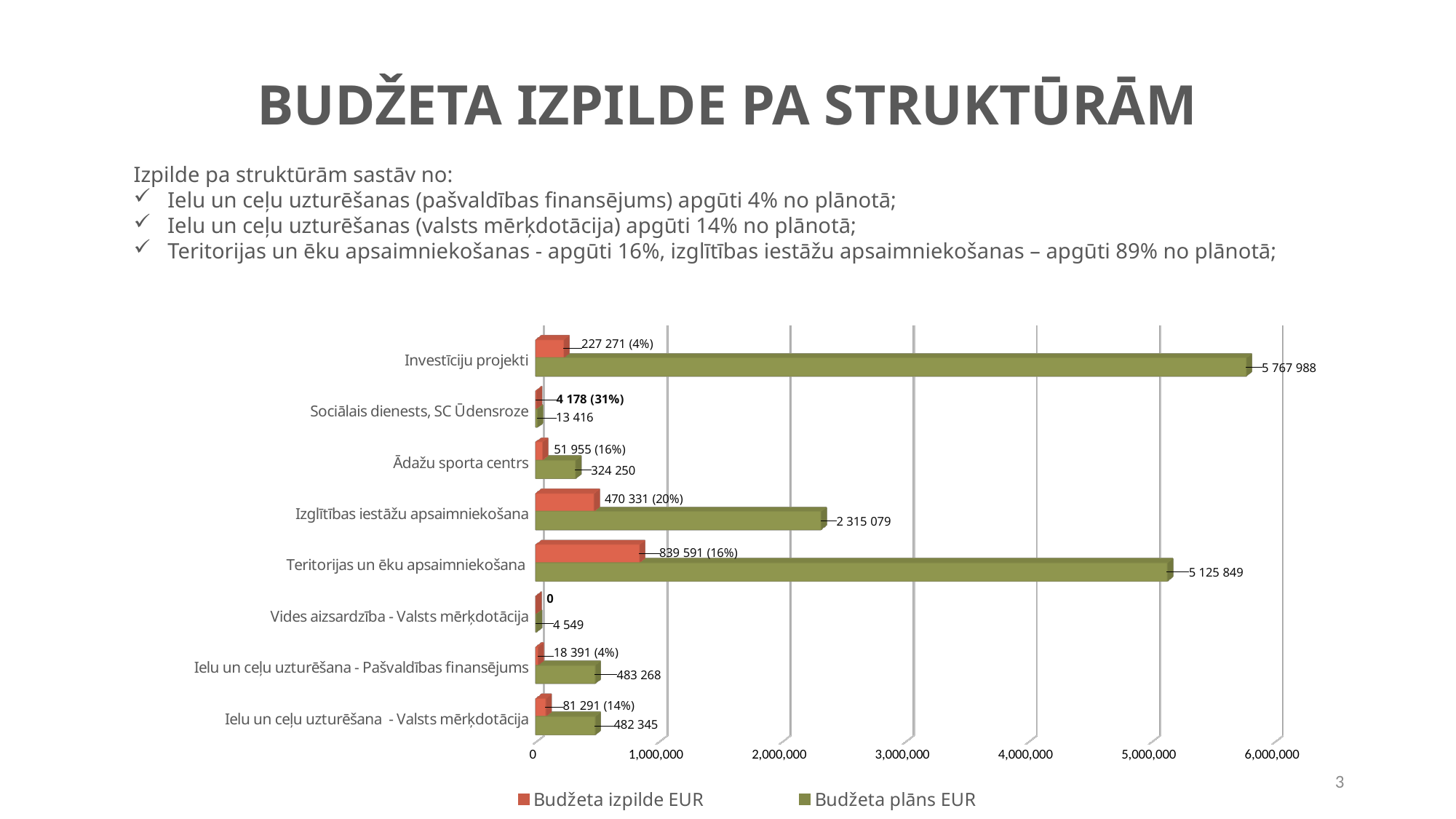
How many categories are shown on the chart? 8 Which category has the highest Budžeta izpilde EUR value? Teritorijas un ēku apsaimniekošana What is the Budžeta izpilde EUR value for Vides aizsardzība - Valsts mērķdotācija? 0 Which is larger: the Budžeta plāns EUR value for Ielu un ceļu uzturēšana - Pašvaldības finansējums or for Ādažu sporta centrs? Ielu un ceļu uzturēšana - Pašvaldības finansējums What is the Budžeta plāns EUR value for Izglītības iestāžu apsaimniekošana? 2 315 079 Which category has the highest Budžeta plāns EUR value? Investīciju projekti What is the Budžeta plāns EUR value for Investīciju projekti? 5 767 988 How many series does the legend list? 2 Which category has the lowest Budžeta plāns EUR value? Vides aizsardzība - Valsts mērķdotācija What kind of chart is shown on the slide? Bar chart What is the difference between the Budžeta plāns EUR and Budžeta izpilde EUR values for Teritorijas un ēku apsaimniekošana? 4 286 258 What is the Budžeta izpilde EUR value for Teritorijas un ēku apsaimniekošana? 839 591 (16%)